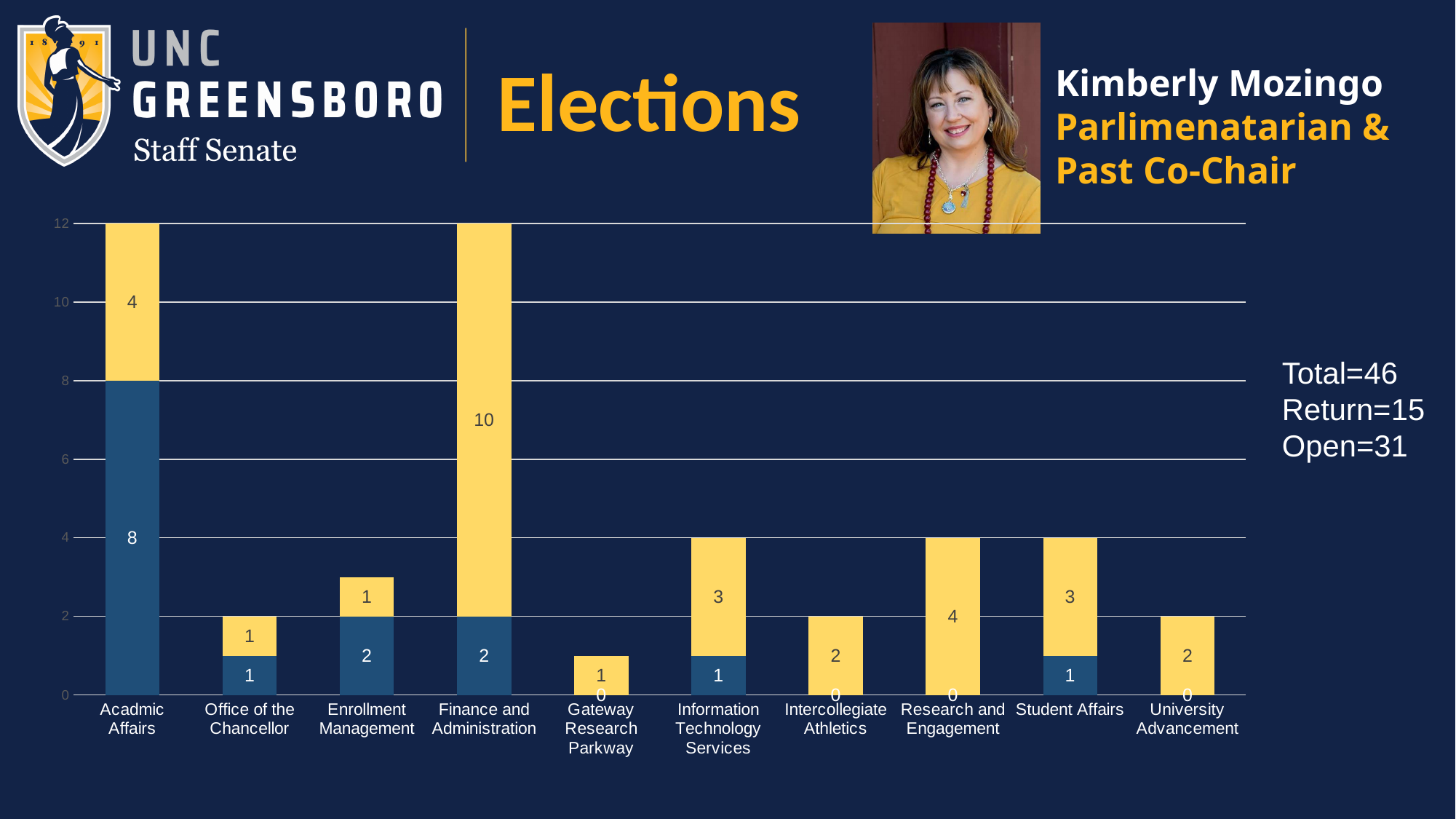
Which is larger, the blue segment for Enrollment Management or the blue segment for Office of the Chancellor? Enrollment Management What is the total height of the stacked bar for Academic Affairs? 12 What is the highest value shown on the y axis of the chart? 12 What kind of chart is shown on the slide? stacked bar chart What is the value of the blue segment for Academic Affairs? 8 What is the value of the blue segment for Gateway Research Parkway? 0 Which category has the tallest yellow segment? Finance and Administration How many categories are shown along the x axis of the chart? 10 What is the value of the yellow segment for Information Technology Services? 3 What is the total height of the stacked bar for Student Affairs? 4 What is the value of the yellow segment for Finance and Administration? 10 What is the difference between the yellow segment for Finance and Administration and the yellow segment for Academic Affairs? 6